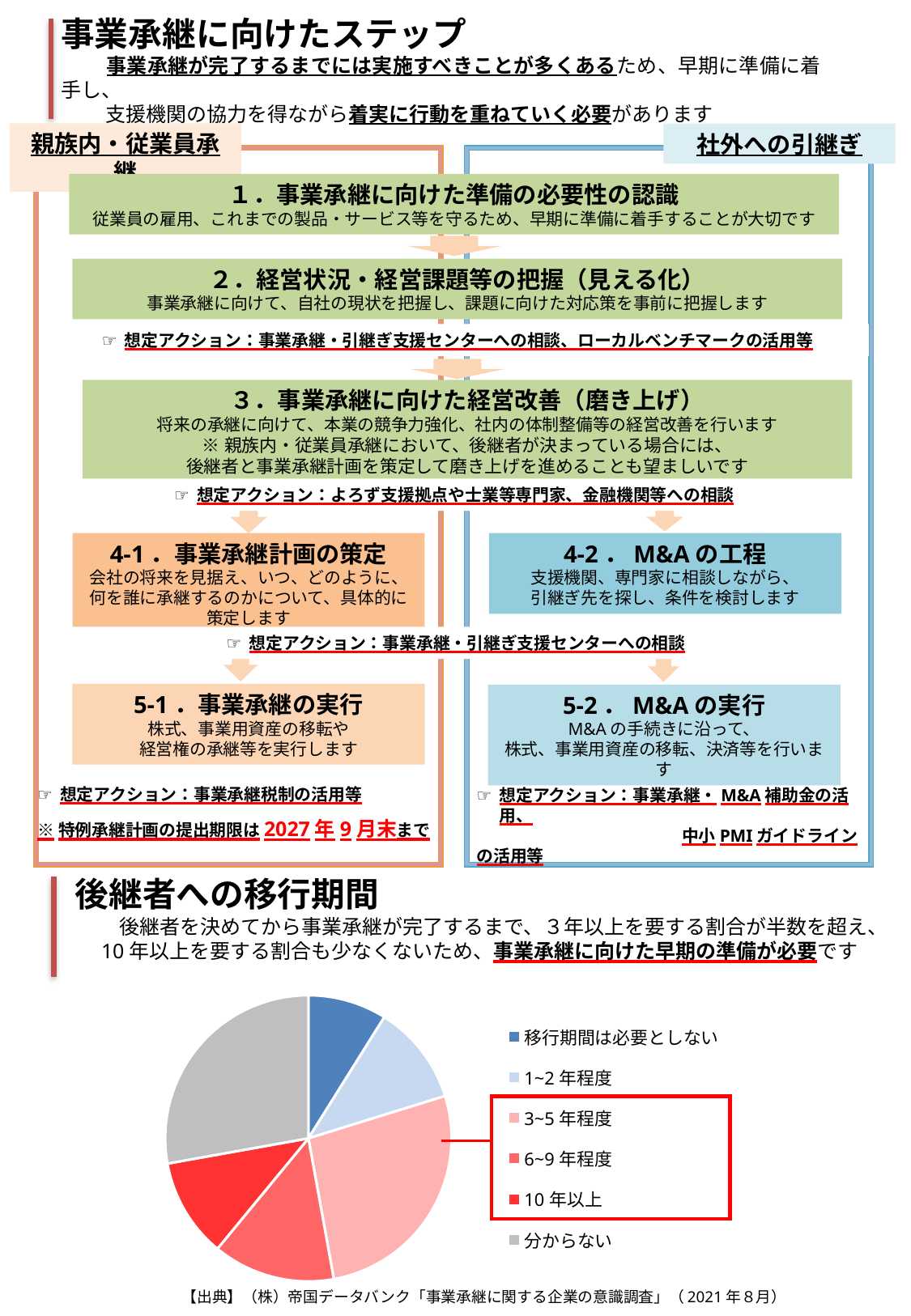
In the pie chart, which slice is larger: 3~5年程度 or 移行期間は必要としない? 3~5年程度 Which three legend entries of the pie chart are enclosed in the red box? 3~5年程度, 6~9年程度, 10年以上 In the pie chart, which slice is larger: 分からない or 1~2年程度? 分からない In the pie chart, which slice is larger: 3~5年程度 or 6~9年程度? 3~5年程度 Which legend entry of the pie chart is shown in grey? 分からない What kind of chart is shown at the bottom of the slide under 後継者への移行期間? pie chart How many categories does the pie chart's legend list? 6 How many entries are in the legend of the pie chart? 6